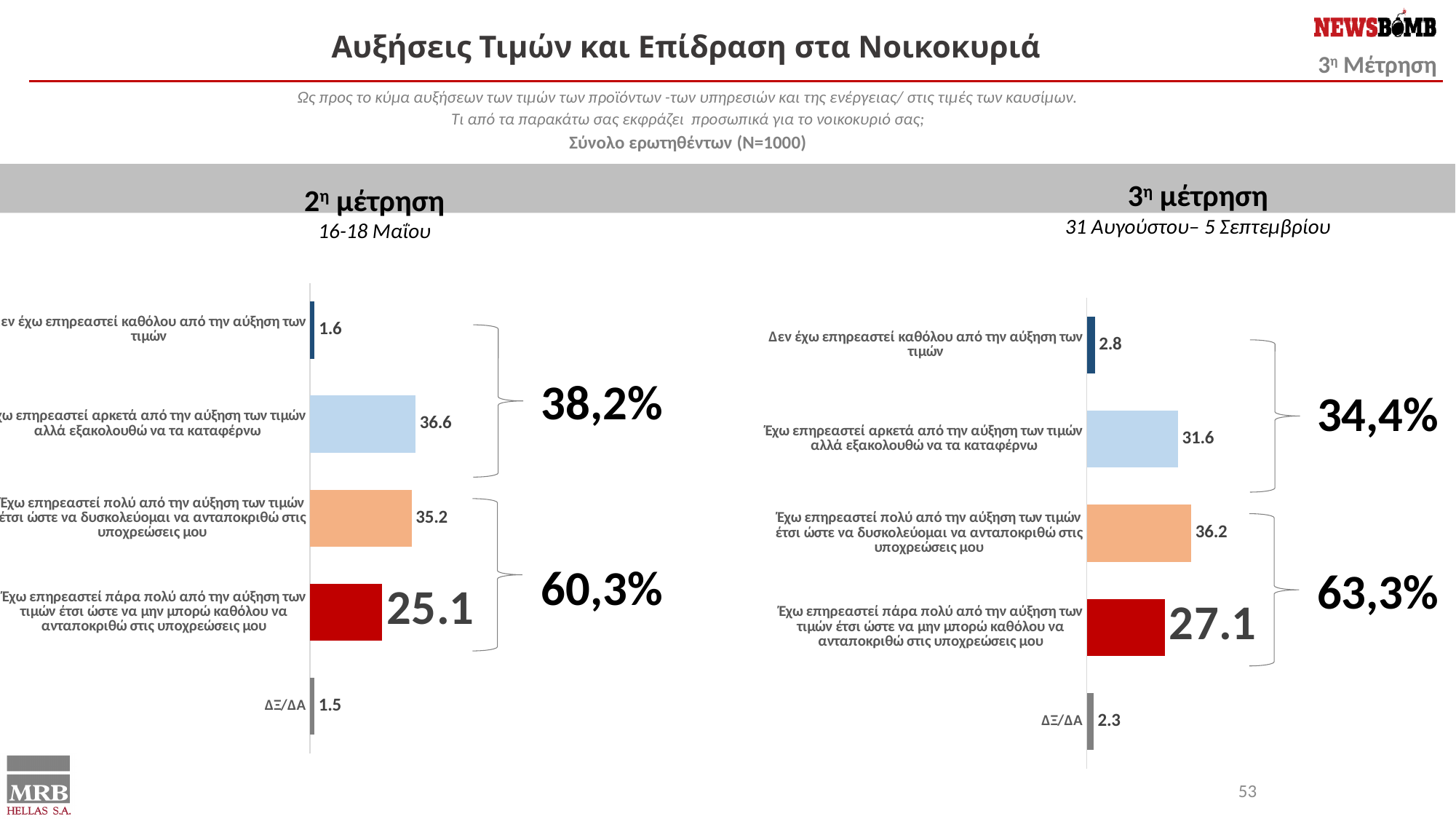
How many categories are shown in the "3η μέτρηση" chart? 5 In the "3η μέτρηση" chart, which category has the highest value? Έχω επηρεαστεί πολύ από την αύξηση των τιμών έτσι ώστε να δυσκολεύομαι να ανταποκριθώ στις υποχρεώσεις μου What type of chart is the "2η μέτρηση" chart? Bar chart In the "2η μέτρηση" chart, which category has the highest value? Έχω επηρεαστεί αρκετά από την αύξηση των τιμών αλλά εξακολουθώ να τα καταφέρνω What combined percentage is shown next to the bracket grouping the two bottom response categories in the "3η μέτρηση" chart? 63,3% In the "2η μέτρηση" chart, what is the difference between the values for "Έχω επηρεαστεί αρκετά..." and "Έχω επηρεαστεί πάρα πολύ..."? 11.5 In the "3η μέτρηση" chart, what is the difference between the values for "Έχω επηρεαστεί πολύ..." (36.2) and "Έχω επηρεαστεί αρκετά..." (31.6)? 4.6 In the "2η μέτρηση" chart, what is the value for "Έχω επηρεαστεί αρκετά από την αύξηση των τιμών αλλά εξακολουθώ να τα καταφέρνω"? 36.6 In the "3η μέτρηση" chart, what is the value for "Έχω επηρεαστεί πάρα πολύ από την αύξηση των τιμών έτσι ώστε να μην μπορώ καθόλου να ανταποκριθώ στις υποχρεώσεις μου"? 27.1 In the "2η μέτρηση" chart, which category has the lowest value? ΔΞ/ΔΑ In the "3η μέτρηση" chart, what is the value for "ΔΞ/ΔΑ"? 2.3 Which is larger: the value for "Έχω επηρεαστεί πάρα πολύ..." in the "2η μέτρηση" chart or in the "3η μέτρηση" chart? 3η μέτρηση